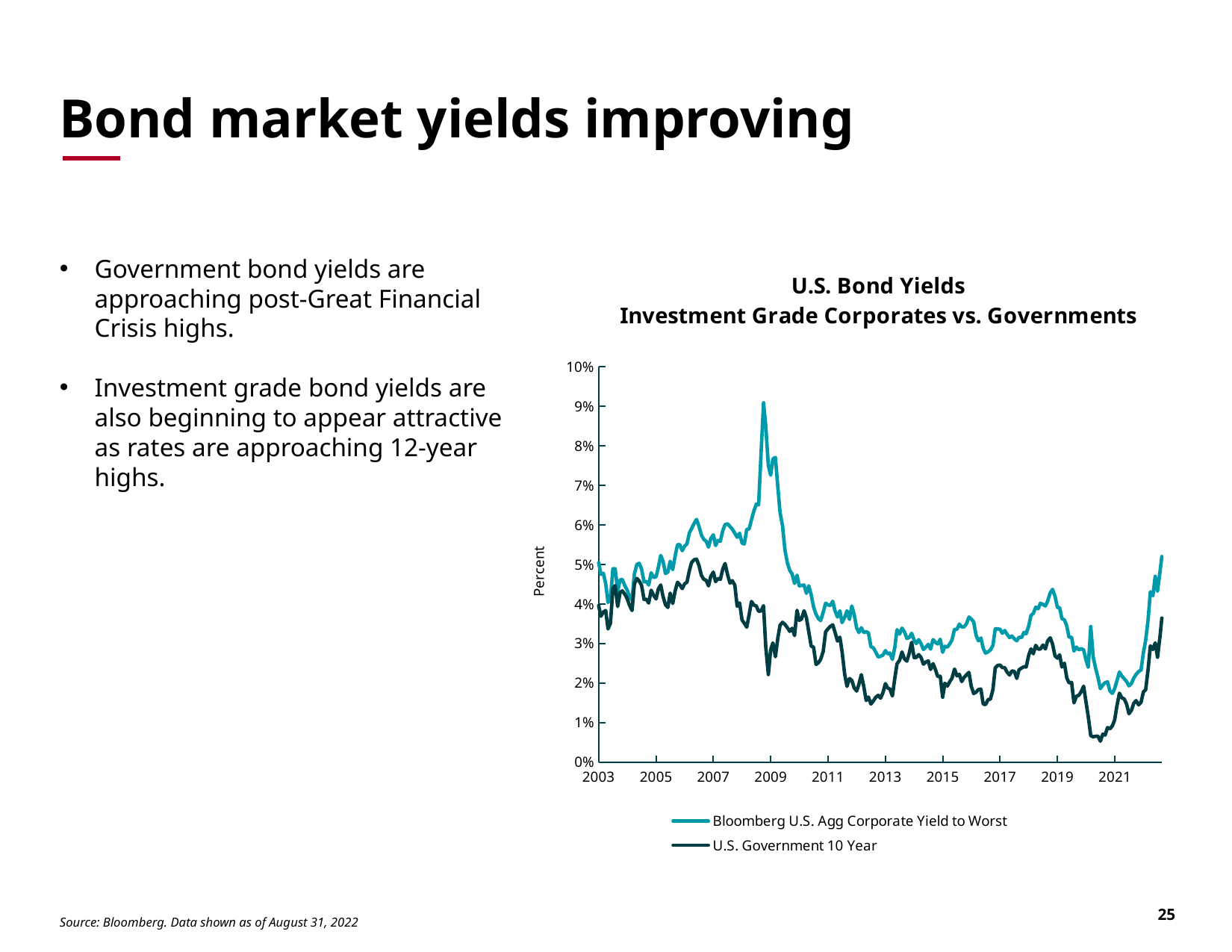
Does the U.S. Government 10 Year line rise or fall from 2020 to the right end of the chart? rise Is the value of the Bloomberg U.S. Agg Corporate Yield to Worst line at the right end of the chart greater or less than 4%? greater Is the peak value of the U.S. Government 10 Year line around 2007 greater or less than 6%? less How many series does the legend list? 2 Does the Bloomberg U.S. Agg Corporate Yield to Worst line rise or fall from its 2009 peak to 2013? fall What kind of chart is shown on the slide? line chart Is the peak value of the Bloomberg U.S. Agg Corporate Yield to Worst line around 2008-2009 greater or less than 8%? greater Which series reaches the highest value anywhere on the chart? Bloomberg U.S. Agg Corporate Yield to Worst What is the label on the y axis of the chart? Percent What is the title of the chart? U.S. Bond Yields Investment Grade Corporates vs. Governments At the right end of the chart, which series is higher: Bloomberg U.S. Agg Corporate Yield to Worst or U.S. Government 10 Year? Bloomberg U.S. Agg Corporate Yield to Worst